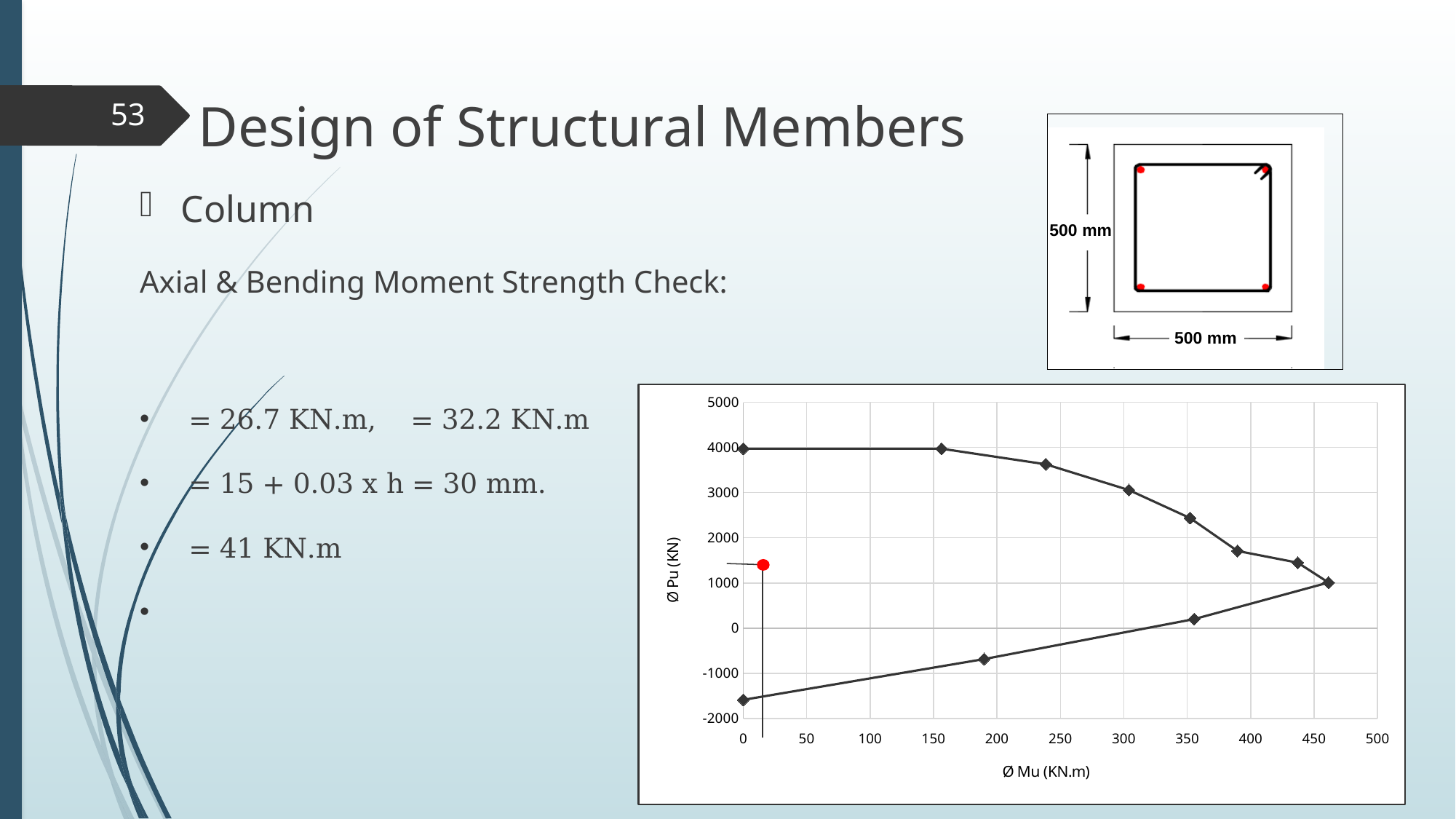
Along the upper branch of the curve, as Ø Mu increases from about 150 to about 450, does Ø Pu rise or fall? fall What kind of chart is shown on the slide? line chart What is the maximum value shown on the y axis of the chart? 5000 Is the Ø Pu value of the red point greater or less than 1000? greater Is the largest Ø Mu value reached by the curve greater or less than 450? greater What is the maximum value shown on the x axis of the chart? 500 Is the Ø Pu value of the highest points on the curve greater or less than 3000? greater What is the title of the x axis of the chart? Ø Mu (KN.m) How many diamond-marked data points are plotted on the curve in the chart? 11 What is the title of the y axis of the chart? Ø Pu (KN) What is the minimum value shown on the y axis of the chart? -2000